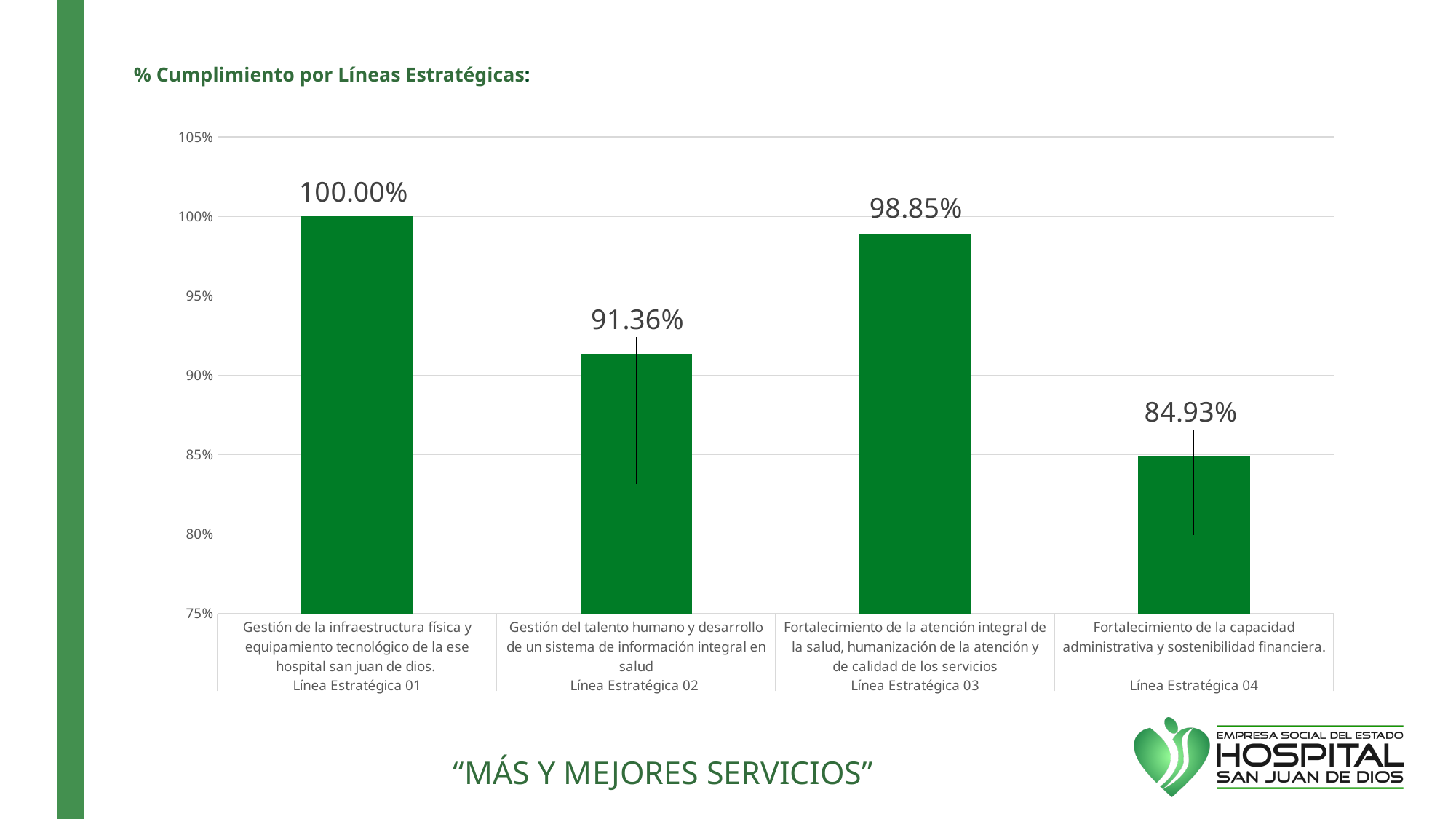
What is the value for Línea Estratégica 03? 98.85% Which is larger, the value for Línea Estratégica 02 or Línea Estratégica 03? Línea Estratégica 03 Which línea estratégica has the highest value? Línea Estratégica 01 What is the title of the chart? % Cumplimiento por Líneas Estratégicas: What is the value for Línea Estratégica 01? 100.00% What kind of chart is shown on the slide? Bar chart What is the value for Línea Estratégica 04 (Fortalecimiento de la capacidad administrativa y sostenibilidad financiera)? 84.93% What is the difference between the values for Línea Estratégica 03 and Línea Estratégica 02? 7.49% What is the value for Línea Estratégica 02 (Gestión del talento humano y desarrollo de un sistema de información integral en salud)? 91.36% What is the difference between the values for Línea Estratégica 01 and Línea Estratégica 04? 15.07% Which línea estratégica has the lowest value? Línea Estratégica 04 How many líneas estratégicas are shown in the chart? 4